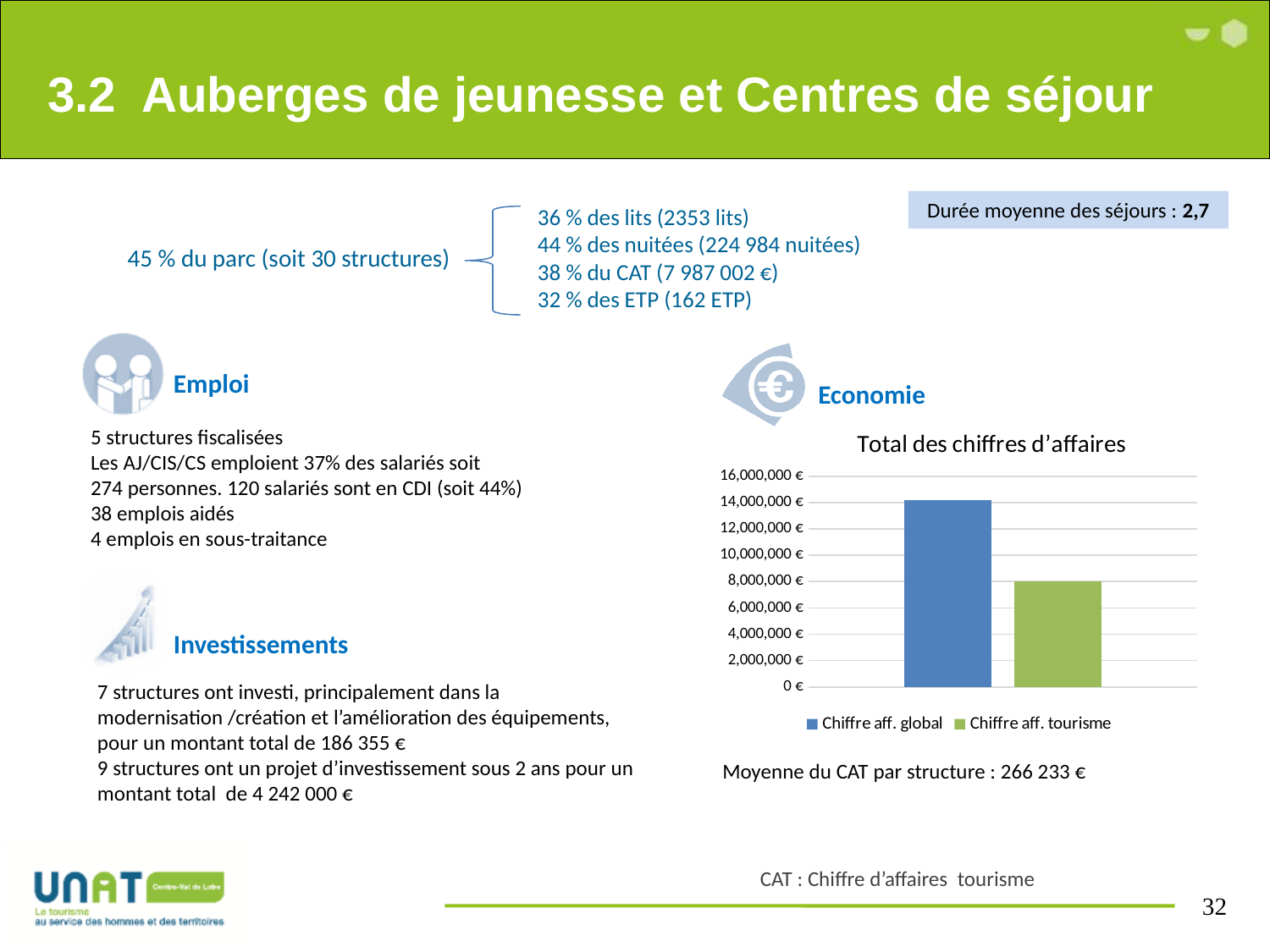
Which is larger in the chart, Chiffre aff. global or Chiffre aff. tourisme? Chiffre aff. global How many series does the legend of the chart list? 2 Is the value for Chiffre aff. global greater or less than 16,000,000 €? less Is the value for Chiffre aff. tourisme greater or less than 10,000,000 €? less What is the title of the chart on the slide? Total des chiffres d'affaires Which series has the lowest bar in the chart? Chiffre aff. tourisme Is the value for Chiffre aff. tourisme greater or less than 6,000,000 €? greater What colour is the bar for Chiffre aff. tourisme in the chart? green How many bars are plotted in the chart? 2 Which series has the highest bar in the chart? Chiffre aff. global What kind of chart is shown under the heading 'Total des chiffres d'affaires'? bar chart